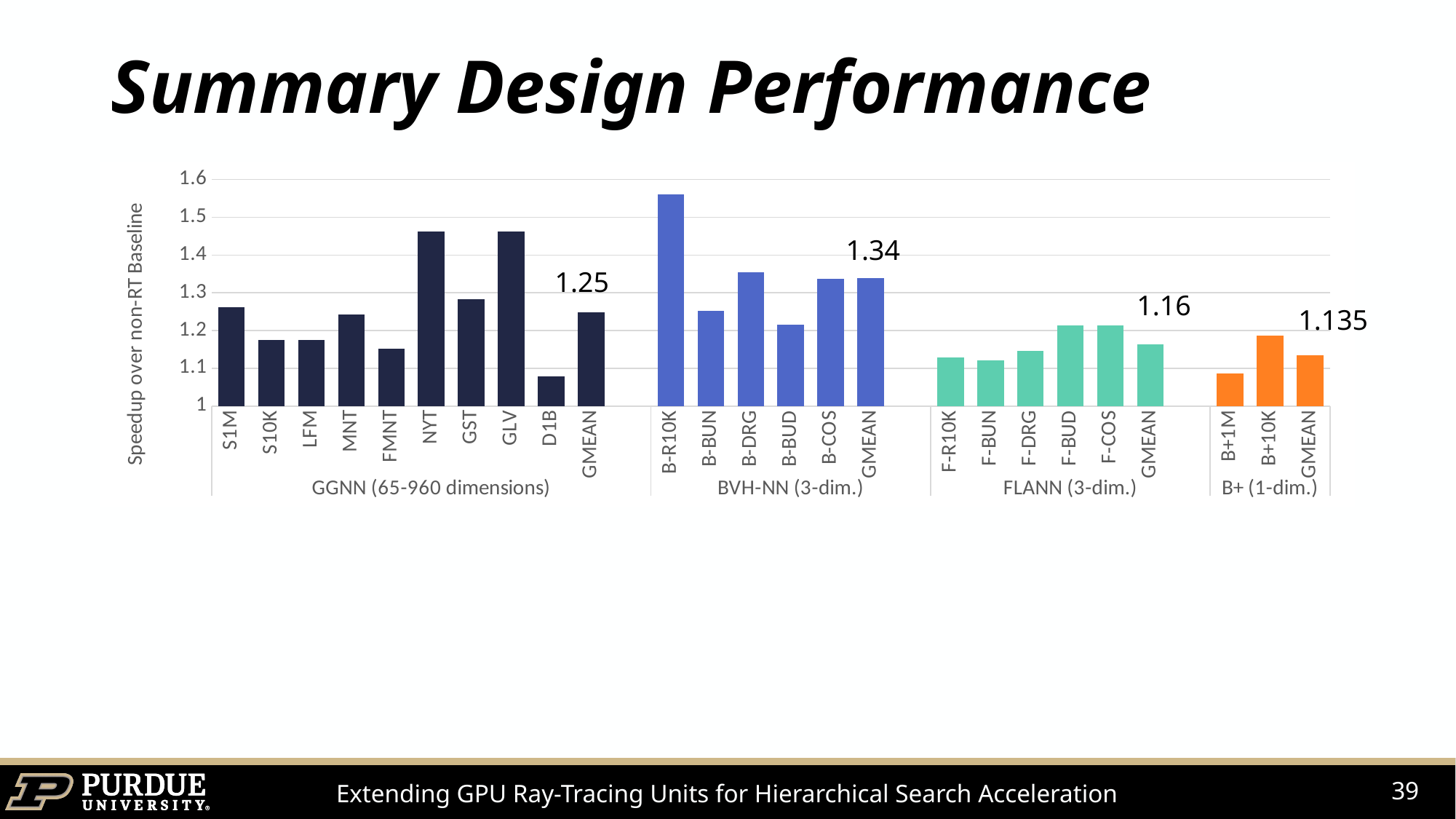
Which single bar in the chart is the tallest? B-R10K What is the GMEAN value shown for the B+ (1-dim.) group? 1.135 What is the GMEAN value shown for the FLANN (3-dim.) group? 1.16 Which is larger, the GMEAN for GGNN or the GMEAN for FLANN? GGNN Is the value for B-R10K greater or less than 1.5? greater What is the y-axis title of the chart? Speedup over non-RT Baseline What is the GMEAN value shown for the BVH-NN (3-dim.) group? 1.34 Which group has the lowest labelled GMEAN speedup? B+ (1-dim.) Which group has the highest labelled GMEAN speedup? BVH-NN (3-dim.) How many bars are in the GGNN (65-960 dimensions) group, including GMEAN? 10 What is the GMEAN value shown for the GGNN (65-960 dimensions) group? 1.25 What is the difference between the BVH-NN GMEAN and the GGNN GMEAN? 0.09